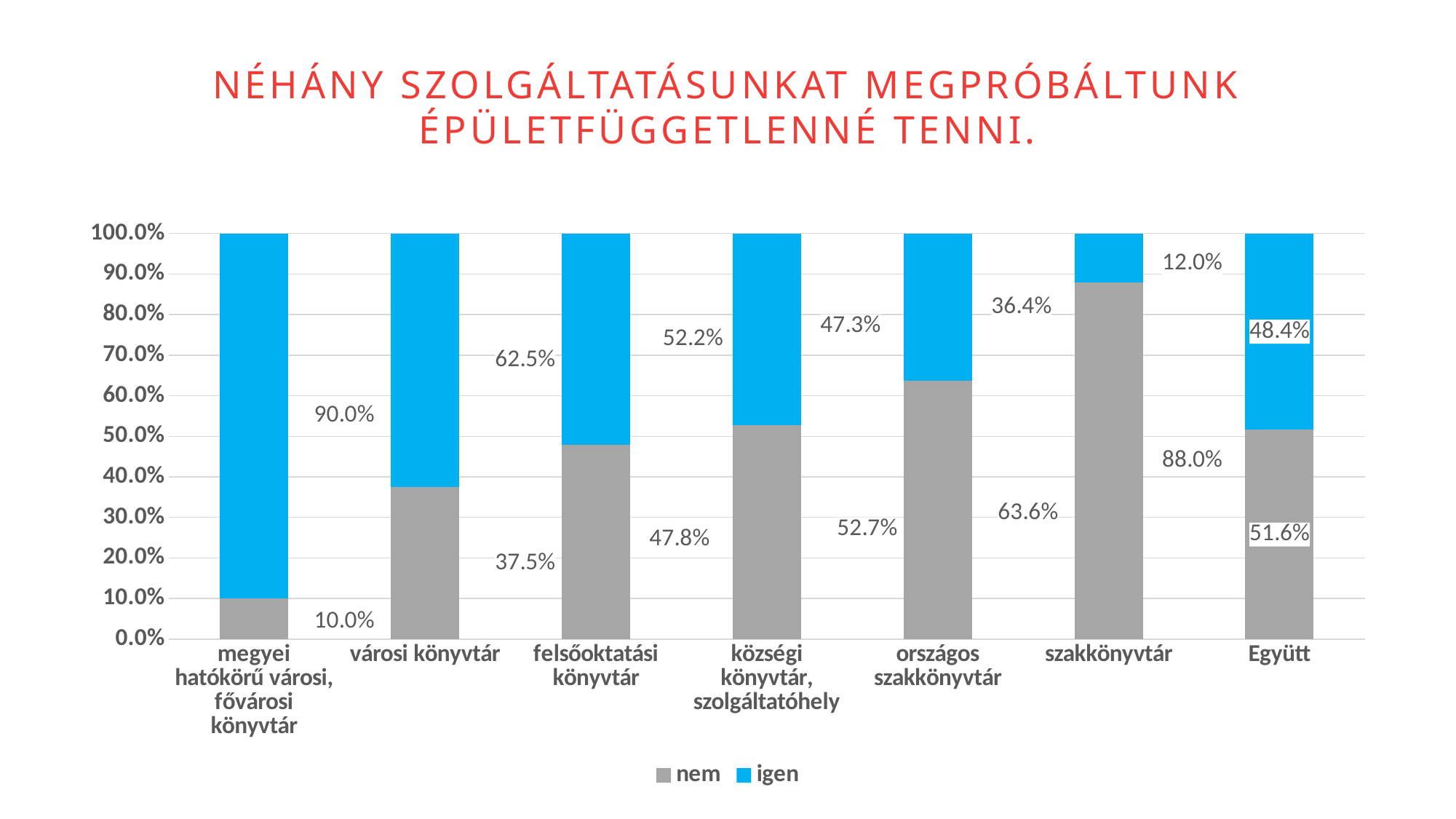
How many series does the legend list? 2 Which category has the lowest 'igen' value? szakkönyvtár Which series is shown in blue according to the legend? igen What is the 'nem' value for szakkönyvtár? 88.0% Which is larger for felsőoktatási könyvtár, the 'nem' value or the 'igen' value? igen What kind of chart is shown on the slide? stacked bar chart What is the 'igen' value for Együtt? 48.4% What is the difference between the 'nem' and 'igen' values for országos szakkönyvtár? 27.2% Which category has the highest 'igen' value? megyei hatókörű városi, fővárosi könyvtár How many categories are shown on the x axis? 7 What is the 'nem' value for városi könyvtár? 37.5% What is the 'igen' value for megyei hatókörű városi, fővárosi könyvtár? 90.0%